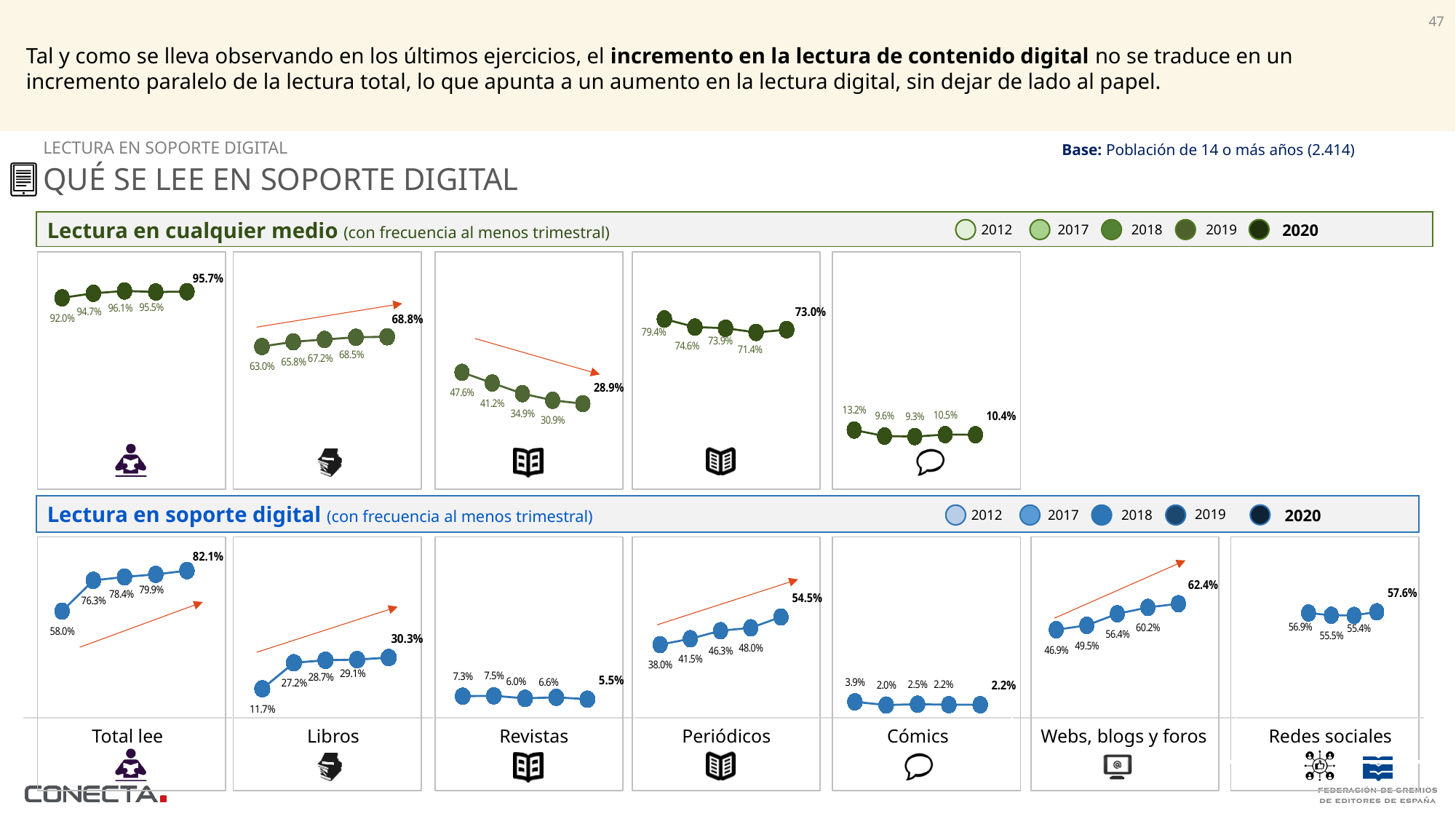
In the 'Lectura en soporte digital' row, what is the difference between the 2020 and 2012 values for Total lee? 24.1% In the 'Lectura en soporte digital' row, what is the 2020 value for Total lee? 82.1% In the 'Lectura en cualquier medio' row, which year has the lowest value in the first chart (Total lee)? 2012 In the 'Lectura en soporte digital' row, which is larger: the 2020 value for Periódicos or the 2020 value for Libros? Periódicos In the 'Lectura en cualquier medio' row, what is the 2020 value in the third chart (Revistas)? 28.9% How many years does the legend of the 'Lectura en soporte digital' section list? 5 In the 'Lectura en soporte digital' row, do the values for Revistas rise or fall from 2012 to 2020? fall How many data points are plotted in the Redes sociales chart? 4 In the 'Lectura en soporte digital' row, what is the 2012 value for Libros? 11.7% In the 'Lectura en soporte digital' row, what is the 2020 value for Webs, blogs y foros? 62.4% In the 'Lectura en soporte digital' row, do the values for Webs, blogs y foros rise or fall from 2012 to 2020? rise In the 'Lectura en soporte digital' row, which year has the highest value for Periódicos? 2020